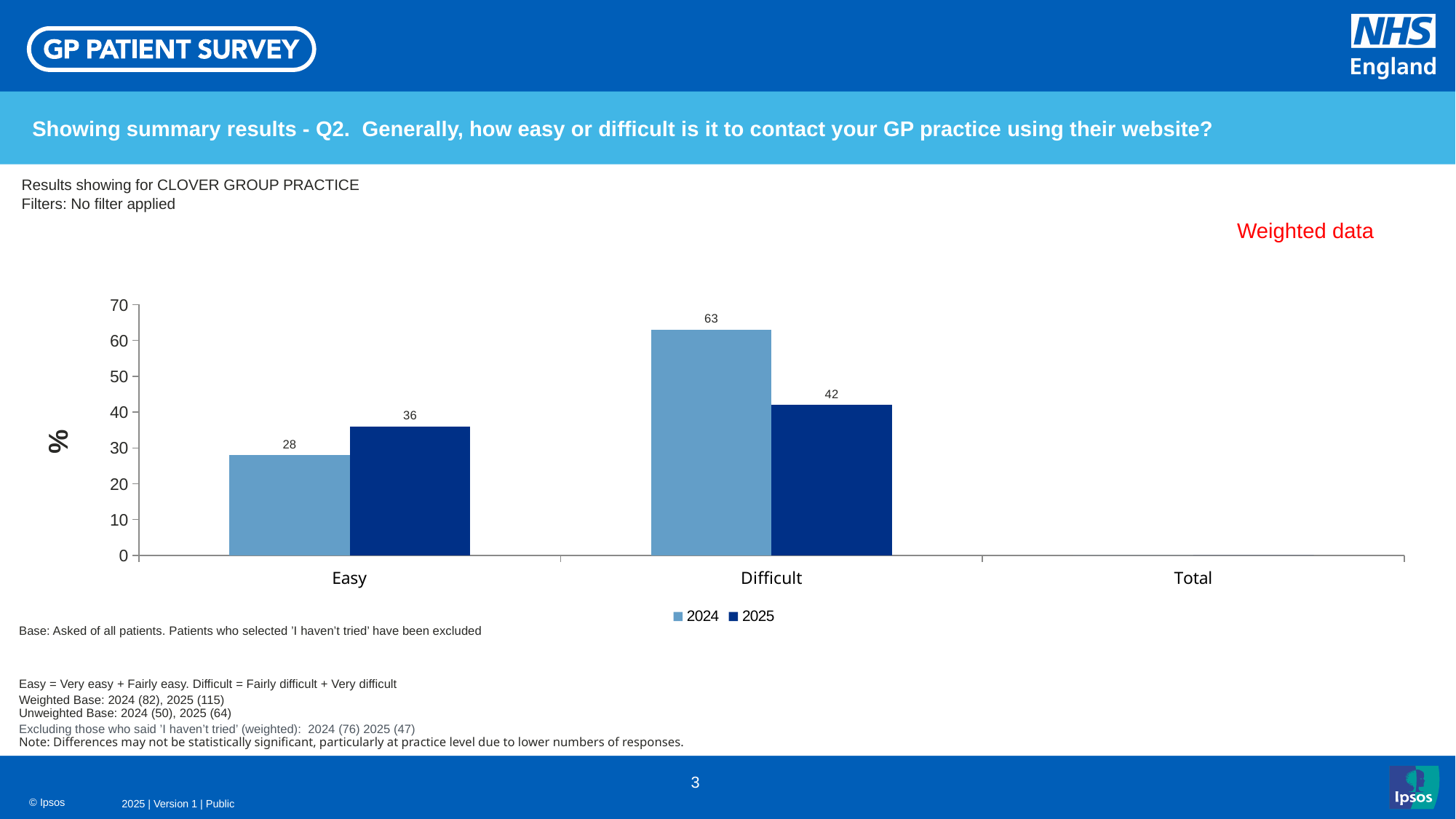
What is the label on the vertical axis of the chart? % What is the difference between the 2024 and 2025 values for Difficult? 21 Which is larger for Easy: the 2024 value or the 2025 value? 2025 What kind of chart is shown on the slide? Bar chart Is the value for Difficult in 2024 greater or less than 60? greater Which category has the lowest value for the 2025 series? Easy What is the value for Easy in 2025? 36 What is the value for Difficult in 2024? 63 Which category has the highest value for the 2024 series? Difficult What is the value for Difficult in 2025? 42 How many series does the legend list? 2 What is the value for Easy in 2024? 28